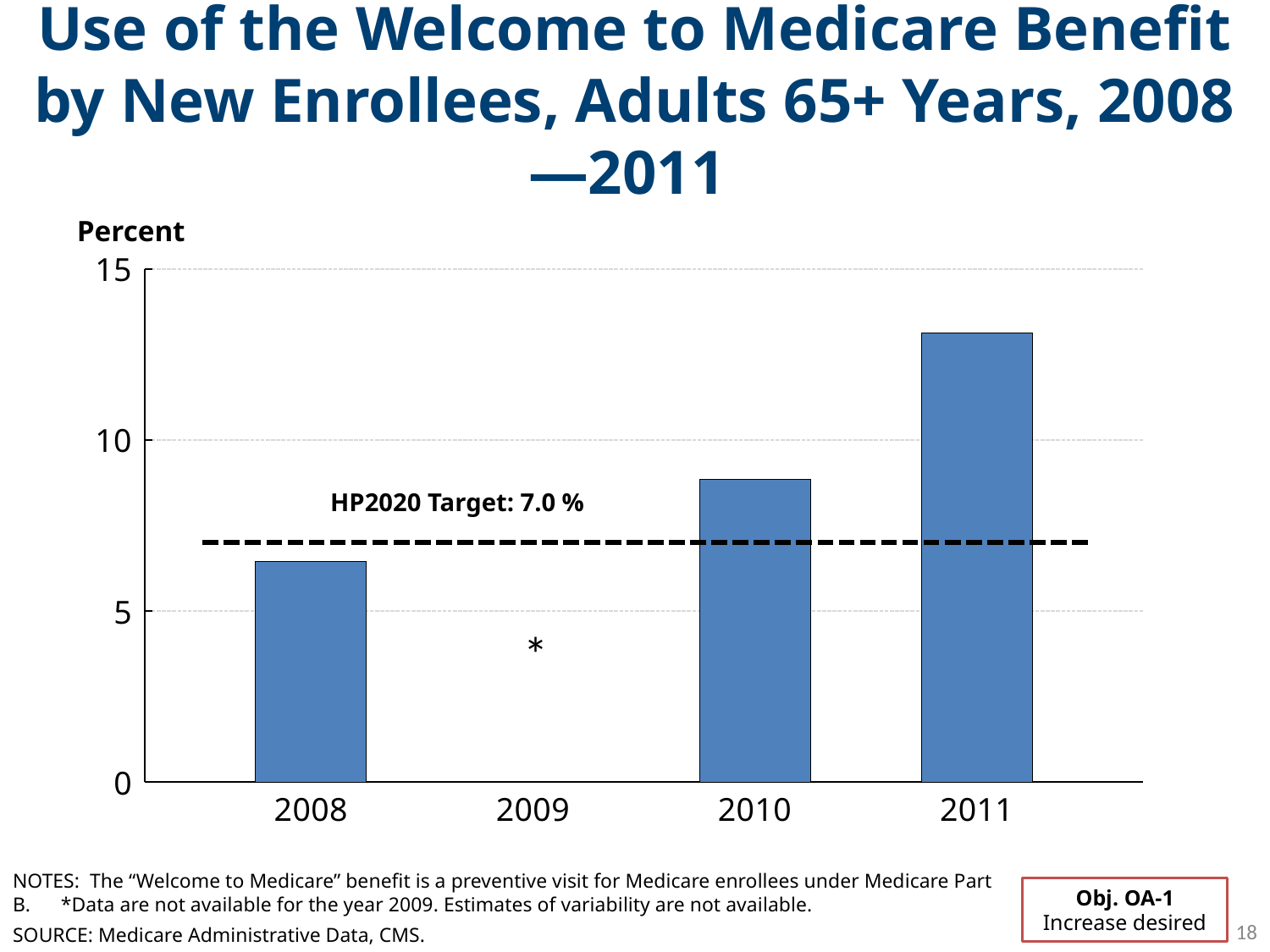
Is the value for 2011 greater or less than 10? greater What is the HP2020 target value shown on the chart? 7.0 % Is the value for 2008 greater or less than 5? greater Among the years with a plotted bar, which year has the lowest value? 2008 Which year has the highest value? 2011 For which year are data not available, as marked by an asterisk? 2009 Is the value for 2010 greater or less than 10? less Do the plotted values rise or fall from 2008 to 2011? rise What kind of chart is shown on the slide? bar chart Which is larger, the value for 2010 or the value for 2008? 2010 How many years are shown on the x axis? 4